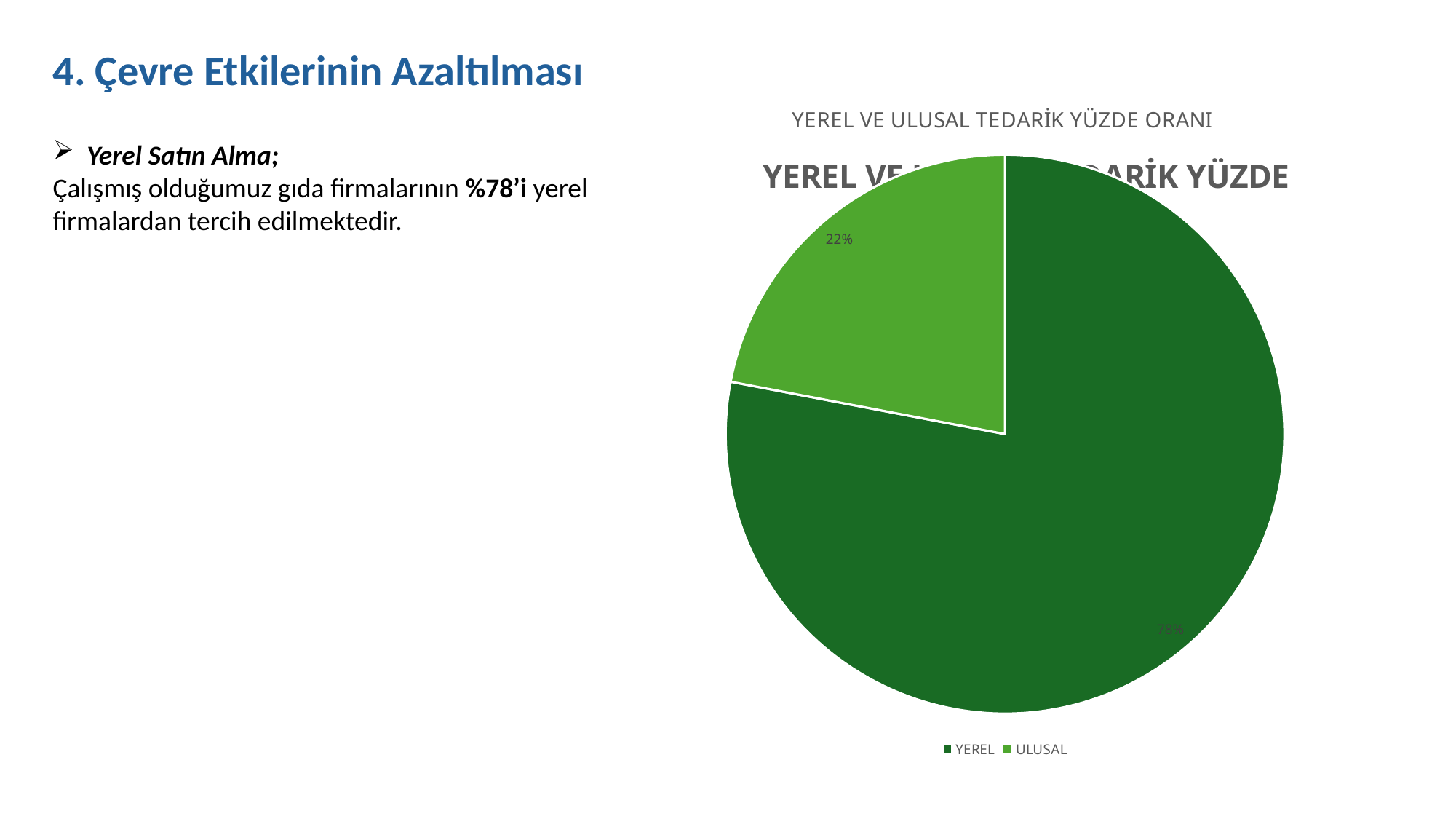
Which category has the largest slice of the pie? YEREL What kind of chart is shown on the slide? Pie chart What is the difference in percentage points between the YEREL and ULUSAL slices? 56 Which categories are listed in the chart legend? YEREL and ULUSAL What share of the pie does ULUSAL represent? 22% Which is larger, the YEREL slice or the ULUSAL slice? YEREL What share of the pie does YEREL represent? 78% What is the title of the chart? YEREL VE ULUSAL TEDARİK YÜZDE ORANI How many categories are shown in the pie chart? 2 Which category has the smallest slice of the pie? ULUSAL